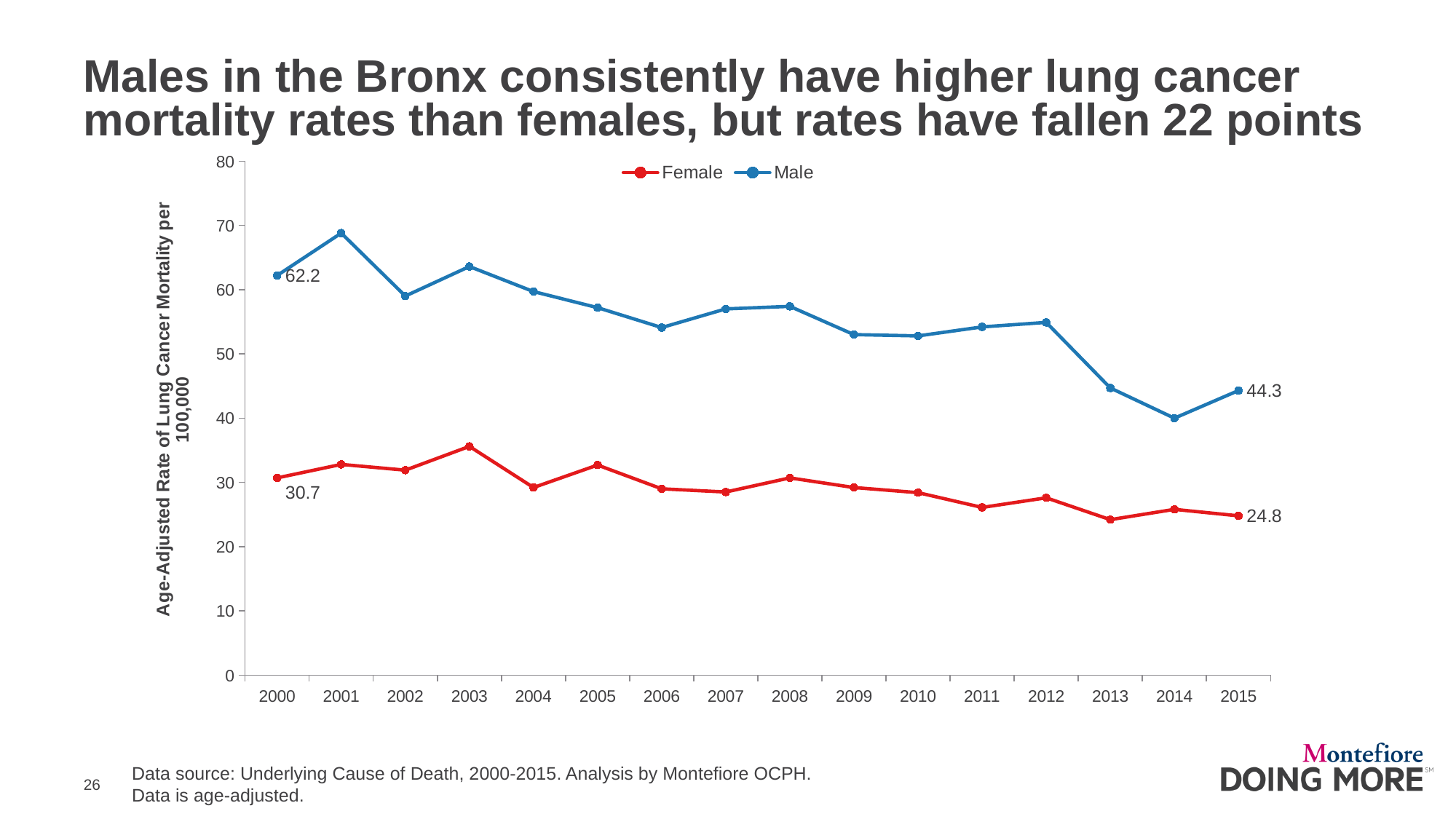
Which year has the lowest Male rate? 2014 What is the Female lung cancer mortality rate in 2000? 30.7 What is the Male lung cancer mortality rate in 2000? 62.2 How many series does the legend list? 2 What is the difference between the Male and Female rates in 2015? 19.5 Is the Female rate in 2003 greater or less than 30? greater Is the Male rate in 2014 greater or less than 50? less What is the Female lung cancer mortality rate in 2015? 24.8 What kind of chart is shown on the slide? Line chart What is the Male lung cancer mortality rate in 2015? 44.3 By how much did the Male rate fall between 2000 and 2015? 17.9 Which year has the highest Male rate? 2001